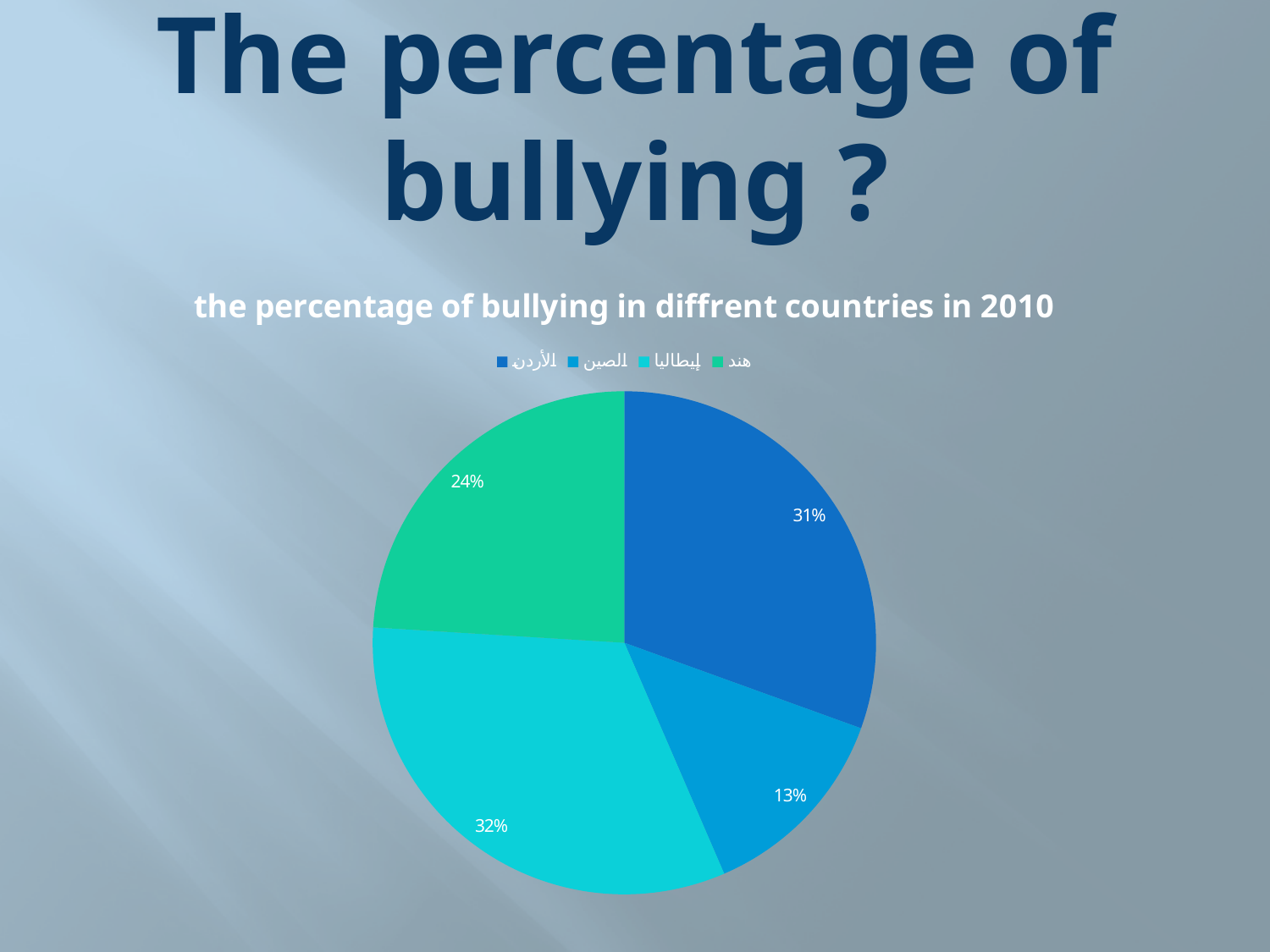
What is the title of the chart? the percentage of bullying in diffrent countries in 2010 How many slices does the pie chart have? 4 What kind of chart is shown on the slide? pie chart How many entries does the legend list? 4 Which country has the largest slice of the pie? إيطاليا What percentage is shown for الصين? 13% What is the difference between the percentages for هند and الصين? 11% What percentage is shown for إيطاليا? 32% What percentage is shown for هند? 24% Which is larger, the slice for الأردن or the slice for هند? الأردن Which country has the smallest slice of the pie? الصين What percentage is shown for الأردن? 31%